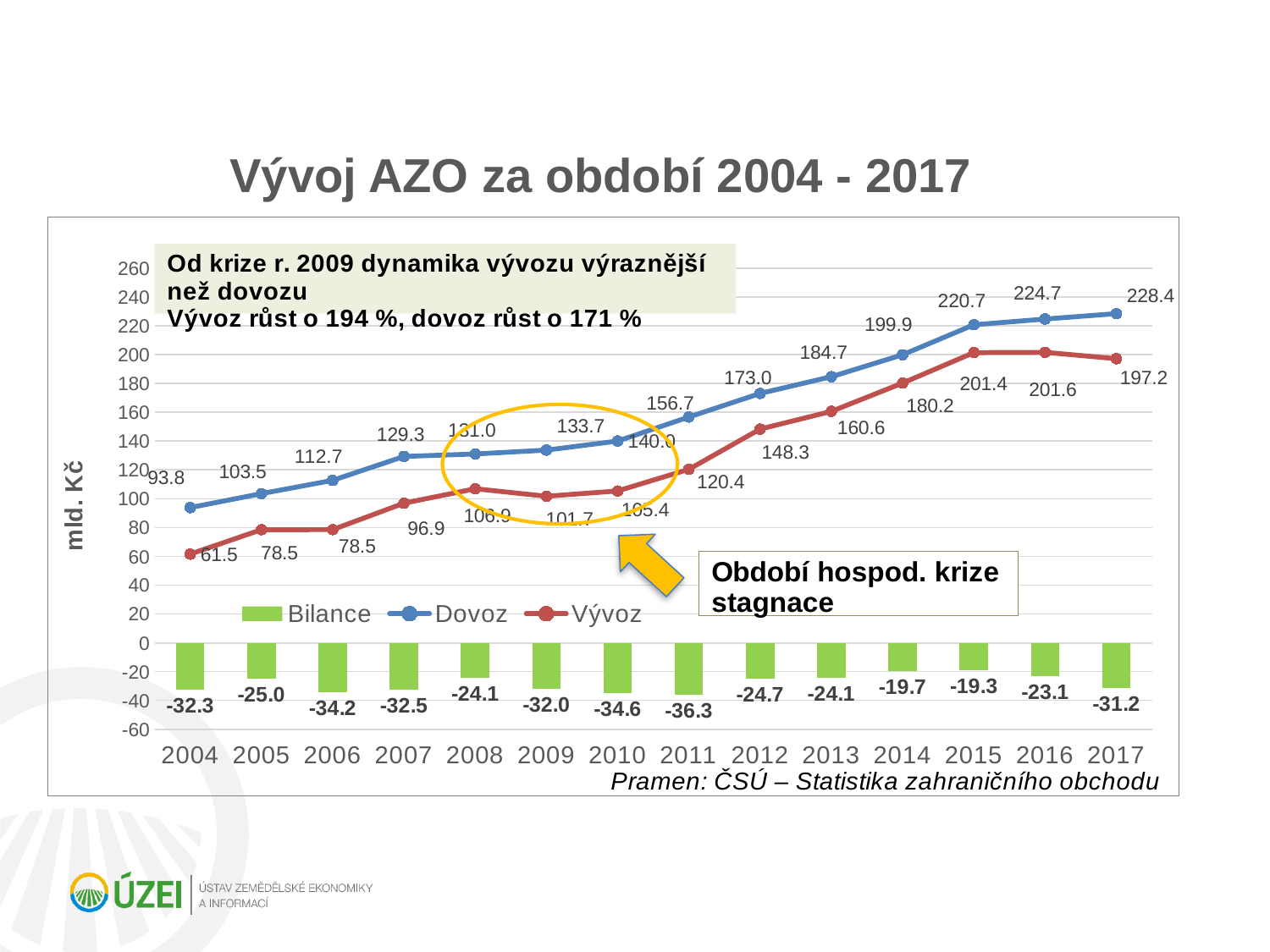
What kind of chart is this? Combination of line chart and bar chart What is the Vývoz value for 2004? 61.5 Does the Dovoz series rise or fall from 2004 to 2017? Rises In which year is the Dovoz series highest? 2017 What is the Bilance value for 2011? -36.3 In which year is the Bilance value lowest (most negative)? 2011 What is the difference between Dovoz and Vývoz in 2017? 31.2 In 2012, which is larger, Dovoz or Vývoz? Dovoz How many series does the legend list? 3 What is the Dovoz value for 2017? 228.4 How many years are shown on the x axis? 14 What is the Vývoz value for 2014? 180.2